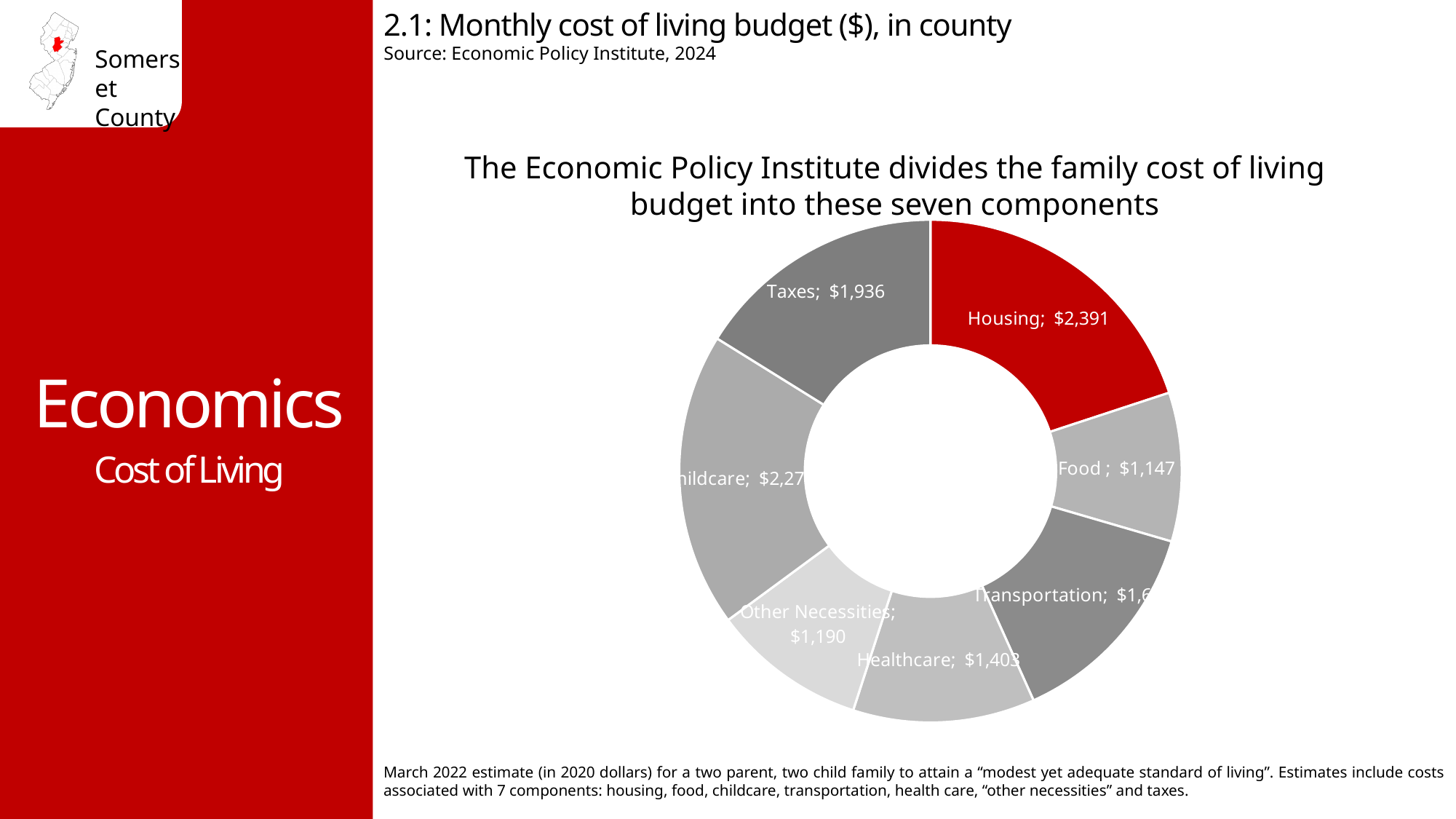
Which component has the largest monthly cost? Housing What is the monthly housing cost shown on the chart? $2,391 What is the monthly cost for Healthcare shown on the chart? $1,403 How many components are shown in the chart? 7 What is the monthly cost for Taxes shown on the chart? $1,936 What type of chart is used on the slide? Donut (pie) chart What is the monthly cost for Other Necessities shown on the chart? $1,190 How much larger is the Housing cost than the Taxes cost? $455 Which is larger, the cost for Taxes or the cost for Healthcare? Taxes Which component has the smallest monthly cost? Food What is the difference between the Healthcare cost and the Food cost? $256 What is the monthly cost for Food shown on the chart? $1,147